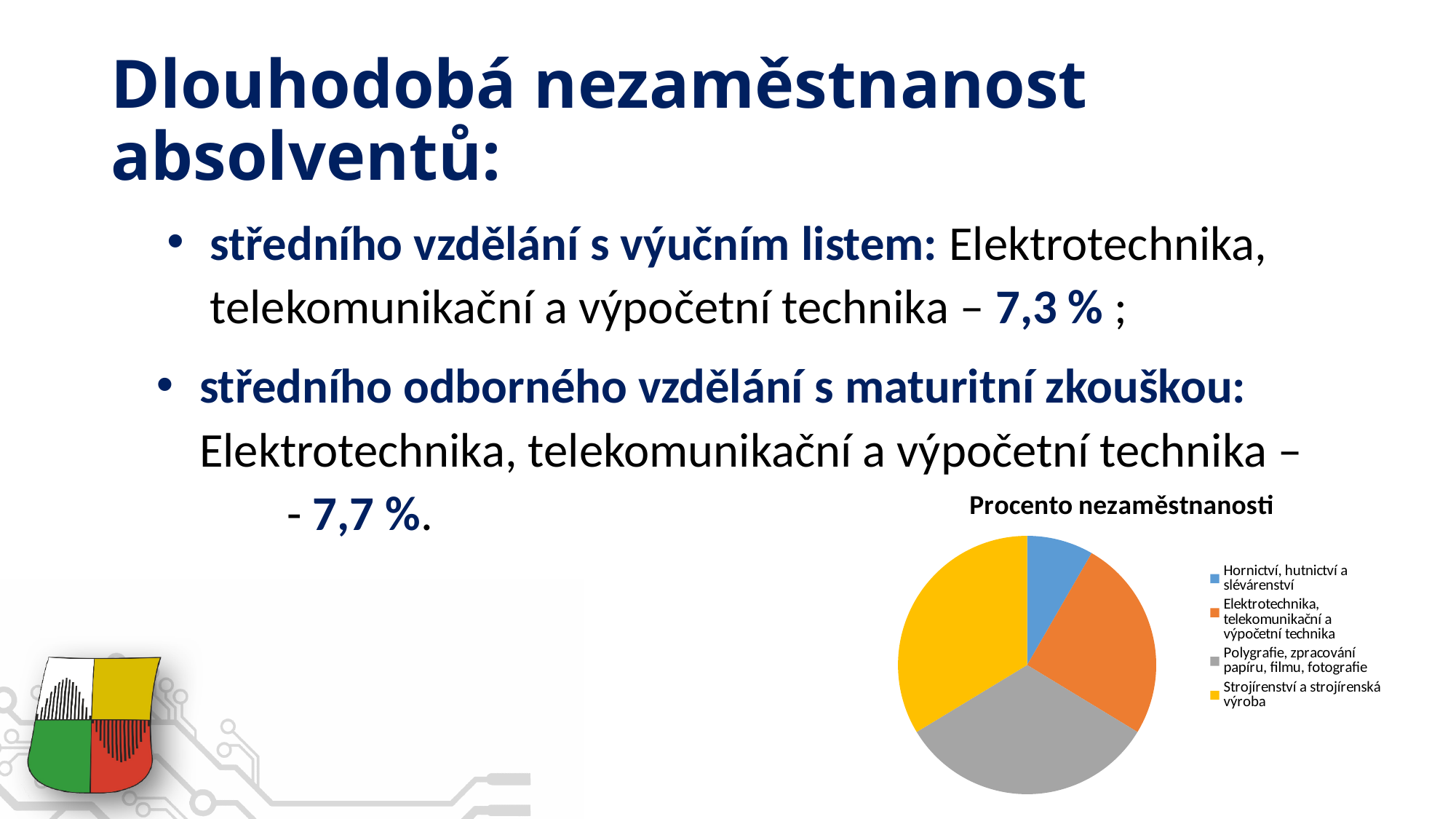
Which slice is larger: Hornictví, hutnictví a slévárenství or Polygrafie, zpracování papíru, filmu, fotografie? Polygrafie, zpracování papíru, filmu, fotografie Which category has the smallest slice of the pie chart? Hornictví, hutnictví a slévárenství What kind of chart is shown on the slide? pie chart What is the title of the pie chart? Procento nezaměstnanosti How many categories does the pie chart show? 4 Which slice is larger: Strojírenství a strojírenská výroba or Elektrotechnika, telekomunikační a výpočetní technika? Strojírenství a strojírenská výroba Which slice is larger: Hornictví, hutnictví a slévárenství or Elektrotechnika, telekomunikační a výpočetní technika? Elektrotechnika, telekomunikační a výpočetní technika What colour represents Strojírenství a strojírenská výroba in the pie chart? yellow